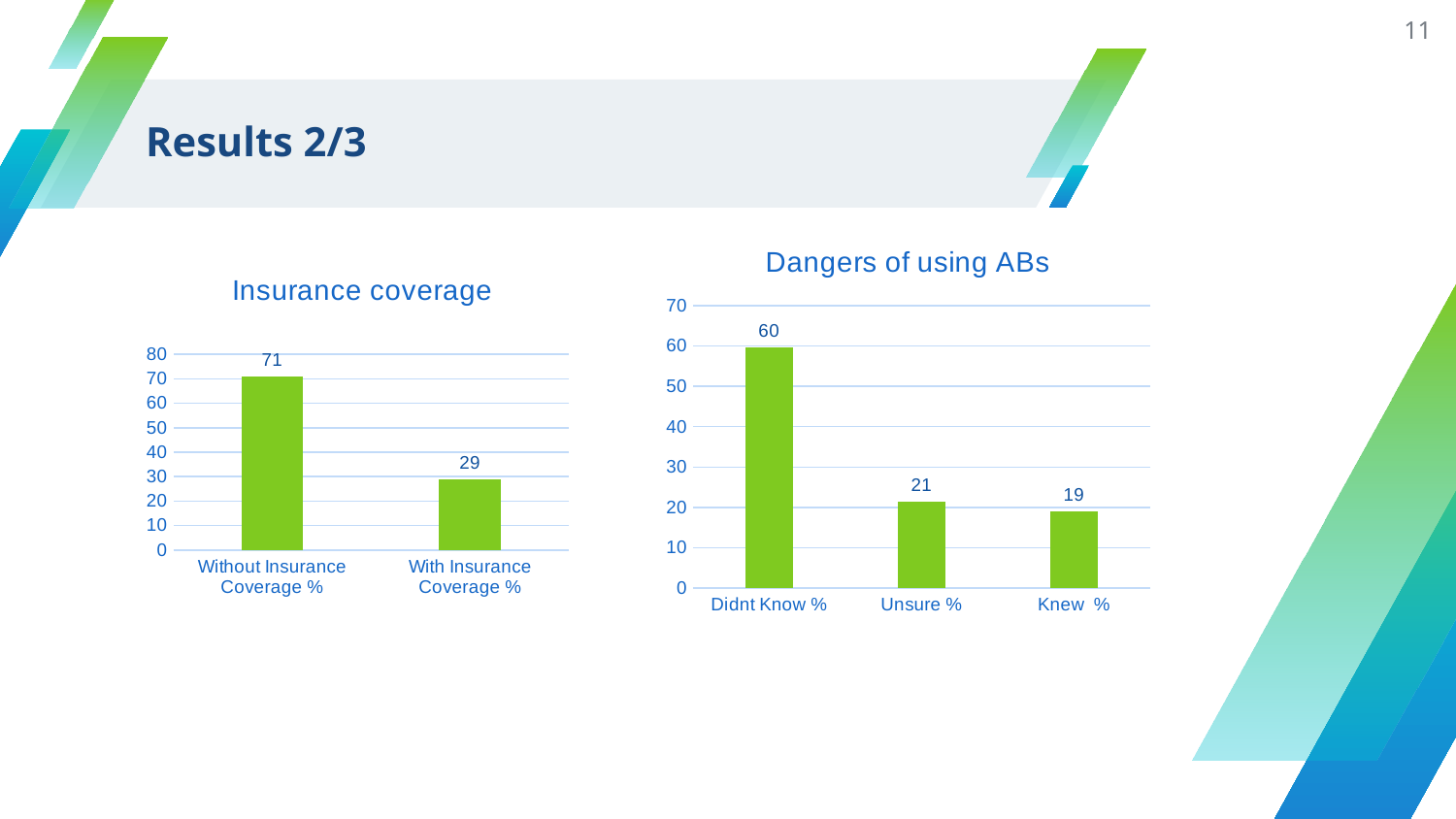
In the 'Insurance coverage' chart, which category has the higher value? Without Insurance Coverage % In the 'Insurance coverage' chart, how many categories are shown? 2 In the 'Insurance coverage' chart, what is the value for 'Without Insurance Coverage %'? 71 In the 'Insurance coverage' chart, what is the difference between 'Without Insurance Coverage %' and 'With Insurance Coverage %'? 42 In the 'Dangers of using ABs' chart, what is the value for 'Unsure %'? 21 In the 'Dangers of using ABs' chart, what is the difference between 'Didnt Know %' and 'Unsure %'? 39 In the 'Insurance coverage' chart, what is the value for 'With Insurance Coverage %'? 29 In the 'Dangers of using ABs' chart, how many categories are shown? 3 What type of chart is the 'Dangers of using ABs' chart? Bar chart In the 'Dangers of using ABs' chart, which category has the lowest value? Knew % In the 'Dangers of using ABs' chart, what is the value for 'Knew %'? 19 In the 'Dangers of using ABs' chart, what is the value for 'Didnt Know %'? 60